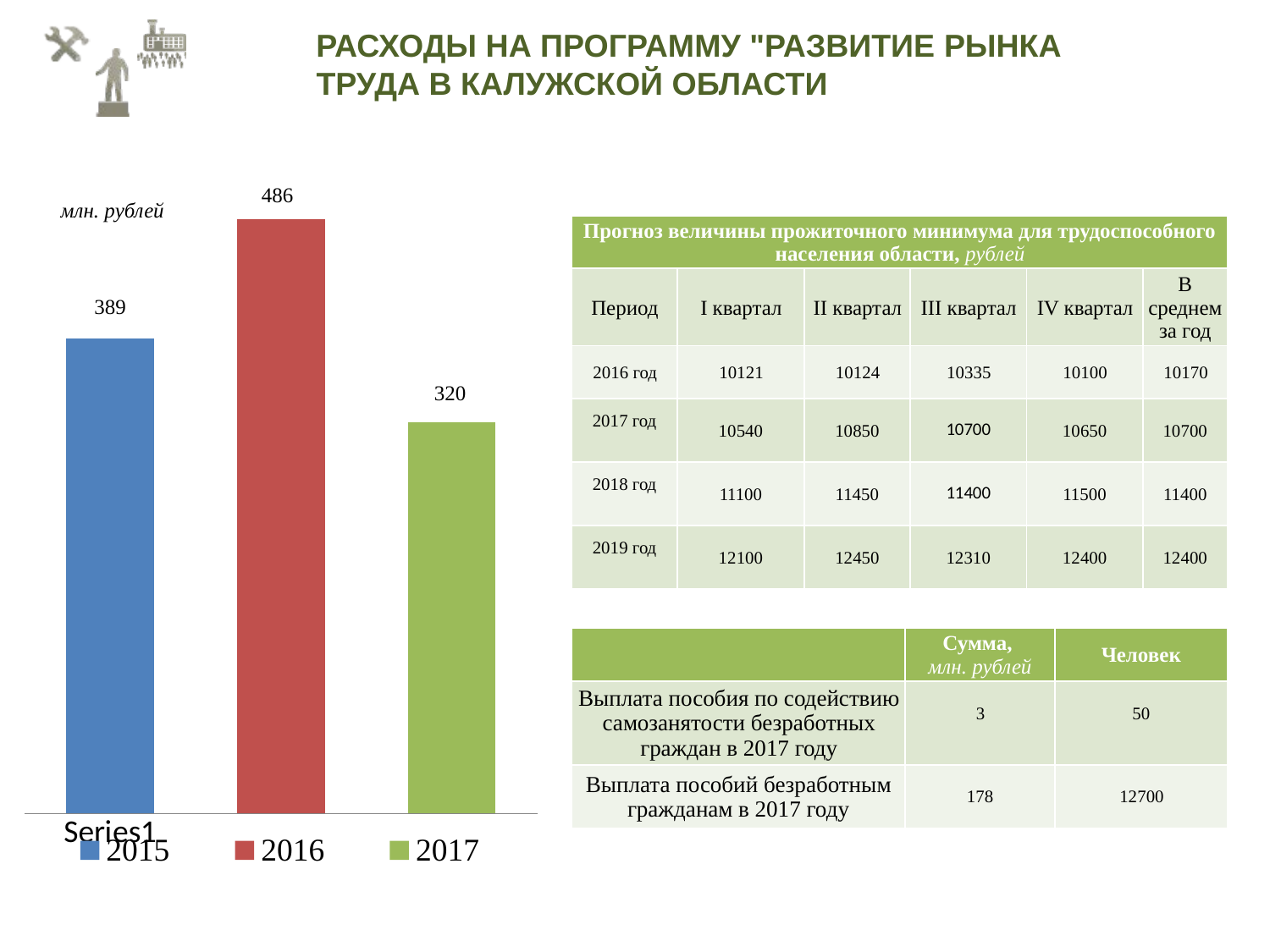
What unit is indicated for the values in the bar chart? млн. рублей How many bars are plotted in the bar chart? 3 Which year has the lowest value in the bar chart? 2017 Which year has the highest value in the bar chart? 2016 What kind of chart is shown on the slide? bar chart What is the difference between the values for 2016 and 2015 in the bar chart? 97 What is the value for 2016 in the bar chart? 486 What is the value for 2015 in the bar chart? 389 What is the difference between the values for 2015 and 2017 in the bar chart? 69 What is the value for 2017 in the bar chart? 320 Which is larger in the bar chart, the value for 2015 or the value for 2017? 2015 How many entries does the legend of the bar chart list? 3